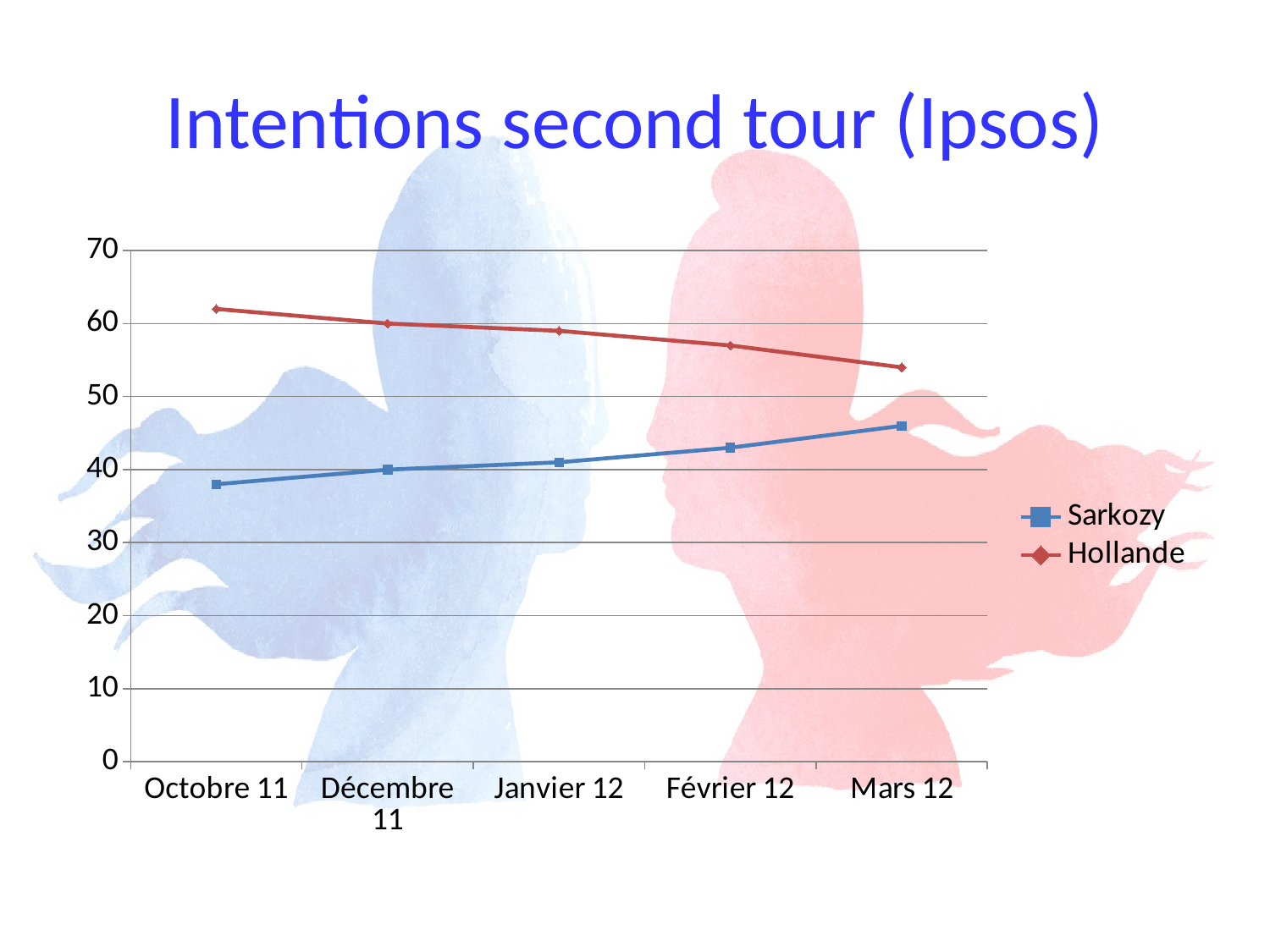
Do the values for Hollande rise or fall from Octobre 11 to Mars 12? fall Is the value for Hollande in Octobre 11 greater or less than 60? greater Is the value for Sarkozy in Octobre 11 greater or less than 40? less Is the value for Hollande in Mars 12 greater or less than 50? greater At which time point is the value for Hollande highest? Octobre 11 How many series does the legend list? 2 Do the values for Sarkozy rise or fall from Octobre 11 to Mars 12? rise How many time points are plotted along the x axis? 5 In Mars 12, which series has the larger value, Sarkozy or Hollande? Hollande What kind of chart is shown on the slide? line chart What is the title of the chart? Intentions second tour (Ipsos)